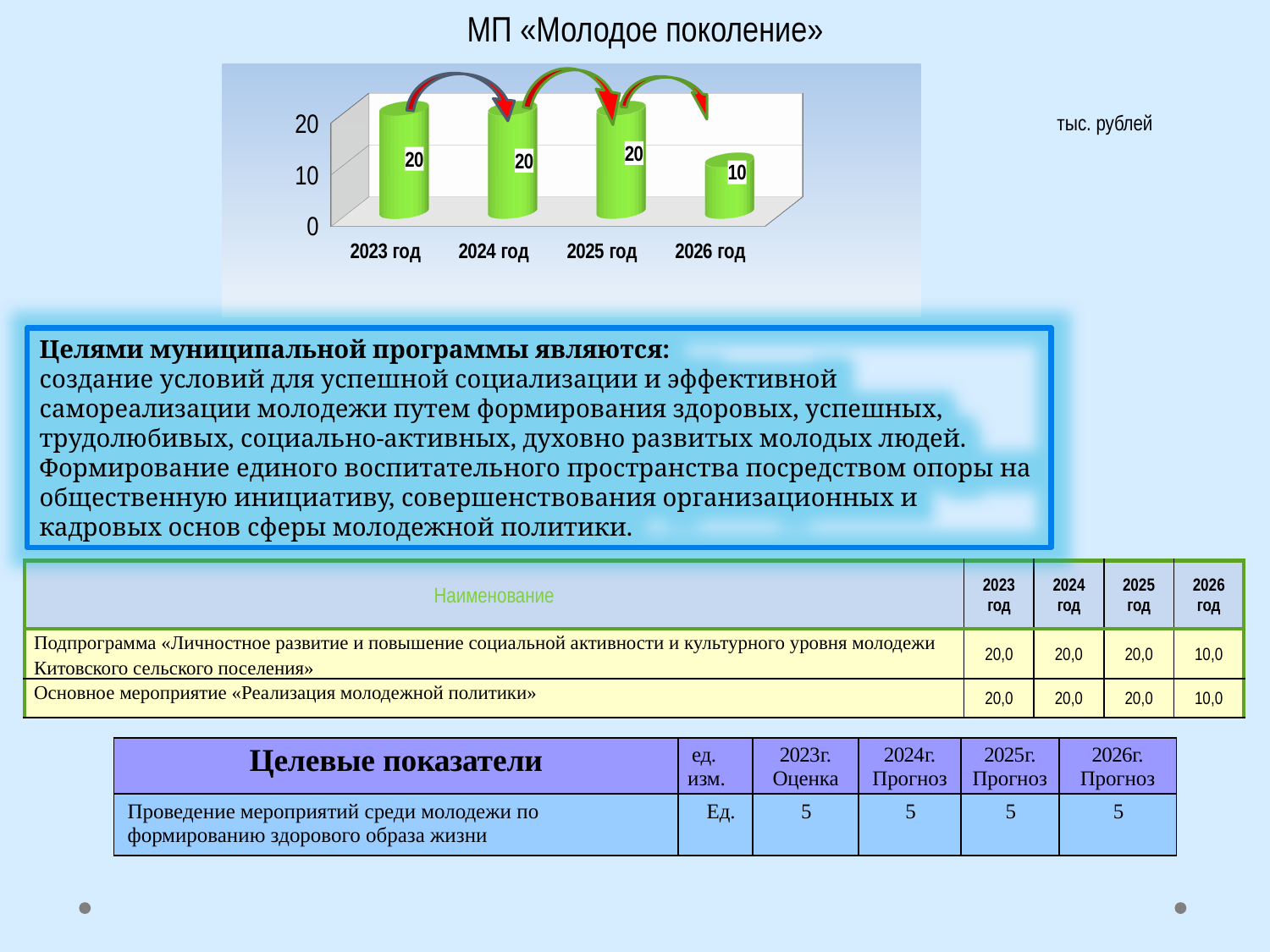
What is the difference between the values for 2025 год and 2026 год? 10 What is the title of the slide above the chart? МП «Молодое поколение» Do the values in the chart rise or fall from 2025 год to 2026 год? fall What unit is indicated next to the chart? тыс. рублей What is the value for 2023 год in the chart? 20 Is the value for 2026 год greater or less than 20? less What kind of chart is shown on the slide? bar chart What is the value for 2025 год in the chart? 20 How many years are shown on the x axis of the chart? 4 What is the value for 2026 год in the chart? 10 Which is larger, the value for 2024 год or the value for 2026 год? 2024 год Which year has the lowest value in the chart? 2026 год